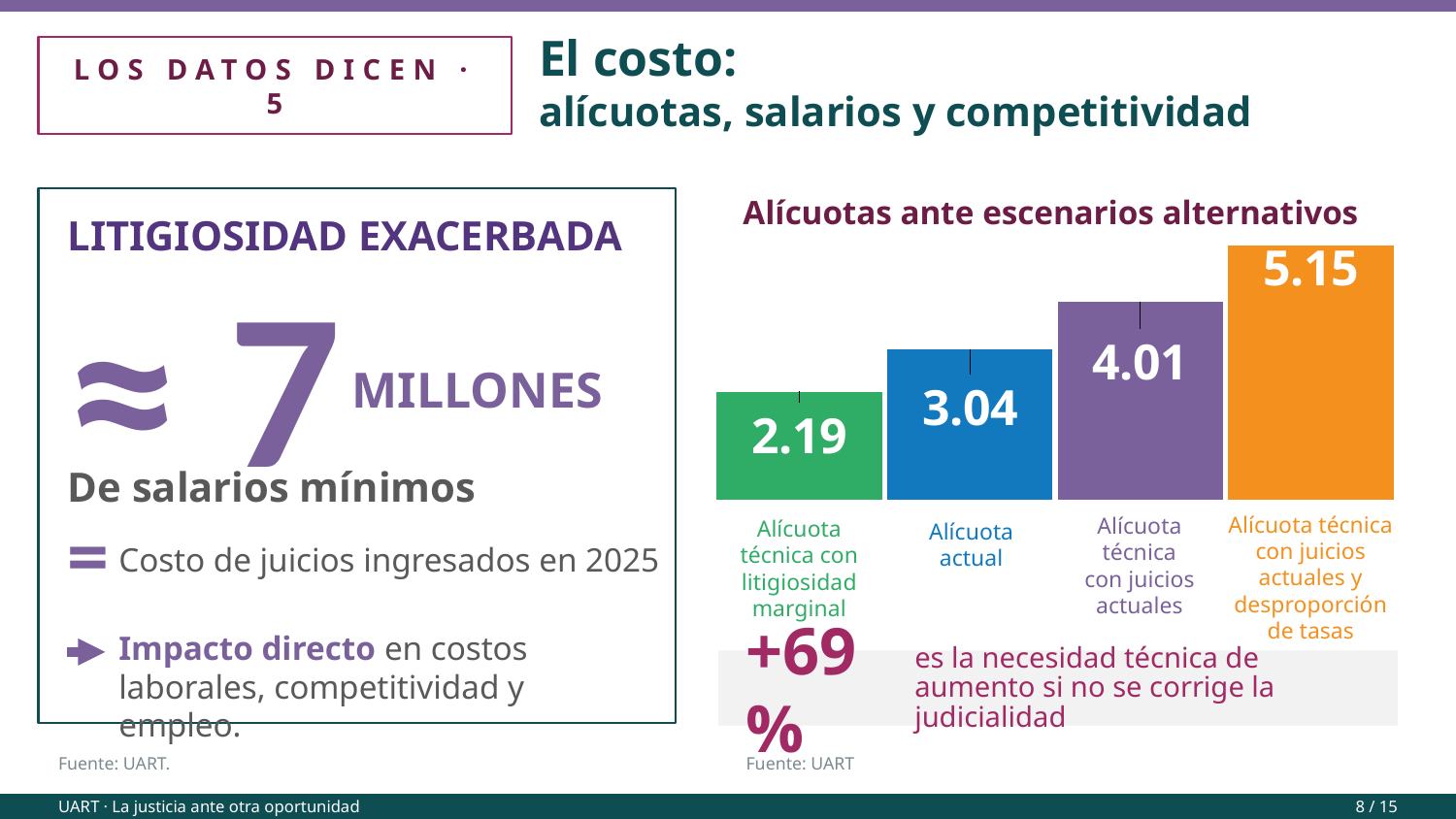
Which category has the lowest value in the chart? Alícuota técnica con litigiosidad marginal What is the value for "Alícuota actual" in the chart? 3.04 What is the title of the chart on the slide? Alícuotas ante escenarios alternativos Which is larger: the value for "Alícuota actual" or the value for "Alícuota técnica con litigiosidad marginal"? Alícuota actual What kind of chart is shown on the slide? Bar chart What is the difference between the highest and lowest values in the chart? 2.96 What is the value for "Alícuota técnica con litigiosidad marginal"? 2.19 What is the difference between the value for "Alícuota técnica con juicios actuales" and the value for "Alícuota actual"? 0.97 What is the value for "Alícuota técnica con juicios actuales"? 4.01 How many bars are shown in the chart? 4 What is the value for "Alícuota técnica con juicios actuales y desproporción de tasas"? 5.15 Which category has the highest value in the chart? Alícuota técnica con juicios actuales y desproporción de tasas